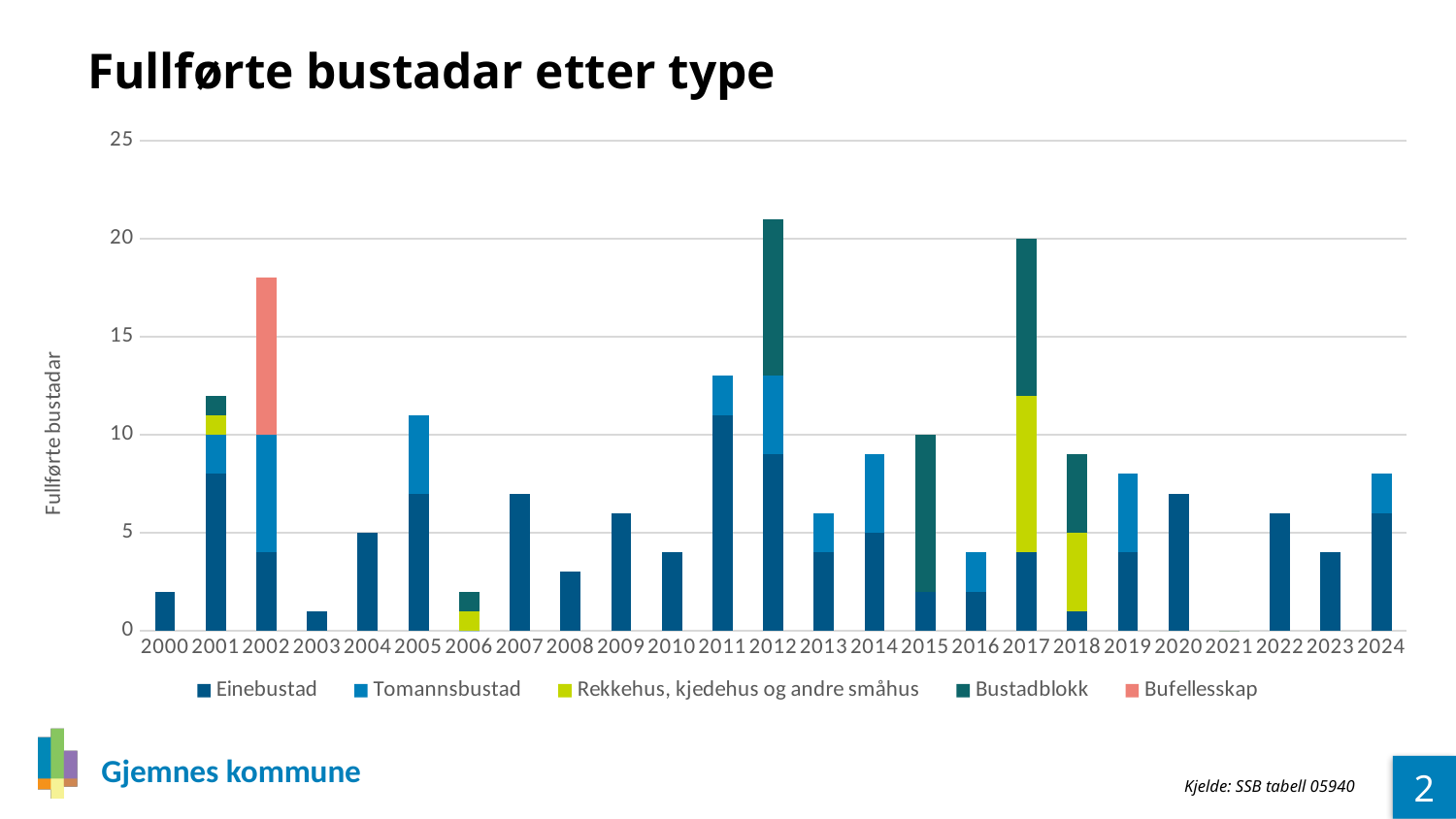
What is the total number of completed dwellings in 2017? 20 Is the total for 2011 greater or less than 15? less Which year has the highest total of completed dwellings? 2012 Is the total for 2002 greater or less than 15? greater What is the total number of completed dwellings in 2015? 10 Which series is shown in the salmon/pink colour in the legend? Bufellesskap Which year has the lowest total of completed dwellings? 2021 How many series does the legend list? 5 What kind of chart is shown on the slide? Stacked bar chart Which year has a larger total, 2012 or 2017? 2012 What is the total number of completed dwellings in 2004? 5 How many years are shown along the x axis? 25